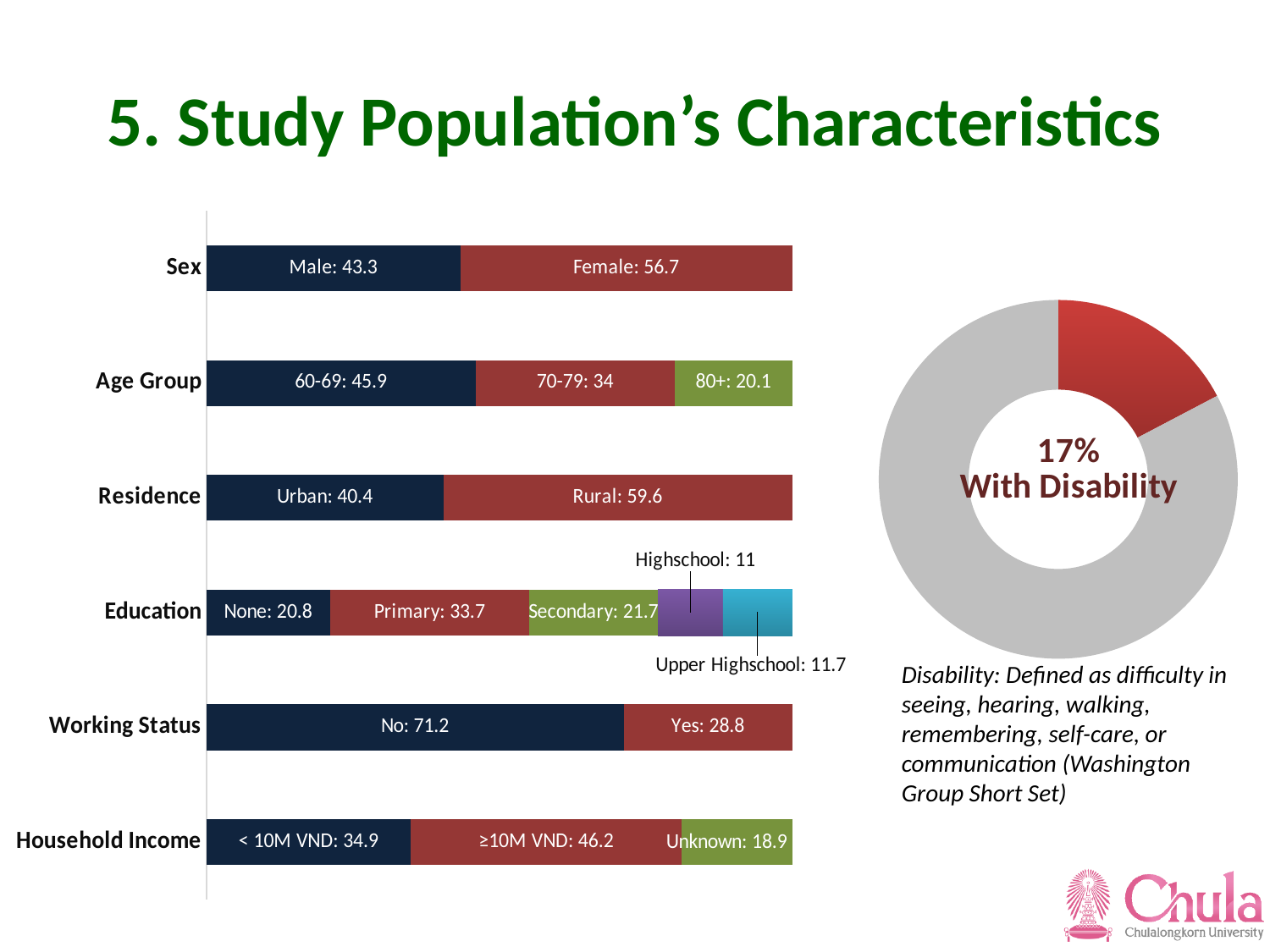
In the stacked bar chart on the left, what is the value for Rural in the Residence bar? 59.6 In the stacked bar chart on the left, which is larger in the Residence bar, Urban or Rural? Rural In the stacked bar chart on the left, what is the value for No in the Working Status bar? 71.2 What kind of chart is the chart on the left of the slide? Stacked bar chart In the donut chart on the right, what share of the study population is shown as having a disability? 17% In the stacked bar chart on the left, what is the value for Male in the Sex bar? 43.3 How many category rows does the stacked bar chart on the left show? 6 In the stacked bar chart on the left, what is the total of the three segments in the Age Group bar? 100 In the stacked bar chart on the left, what is the value for the 80+ segment of the Age Group bar? 20.1 In the stacked bar chart on the left, which segment of the Education bar has the highest value? Primary: 33.7 In the stacked bar chart on the left, what is the difference between the Female and Male values in the Sex bar? 13.4 In the stacked bar chart on the left, what is the value for Unknown in the Household Income bar? 18.9